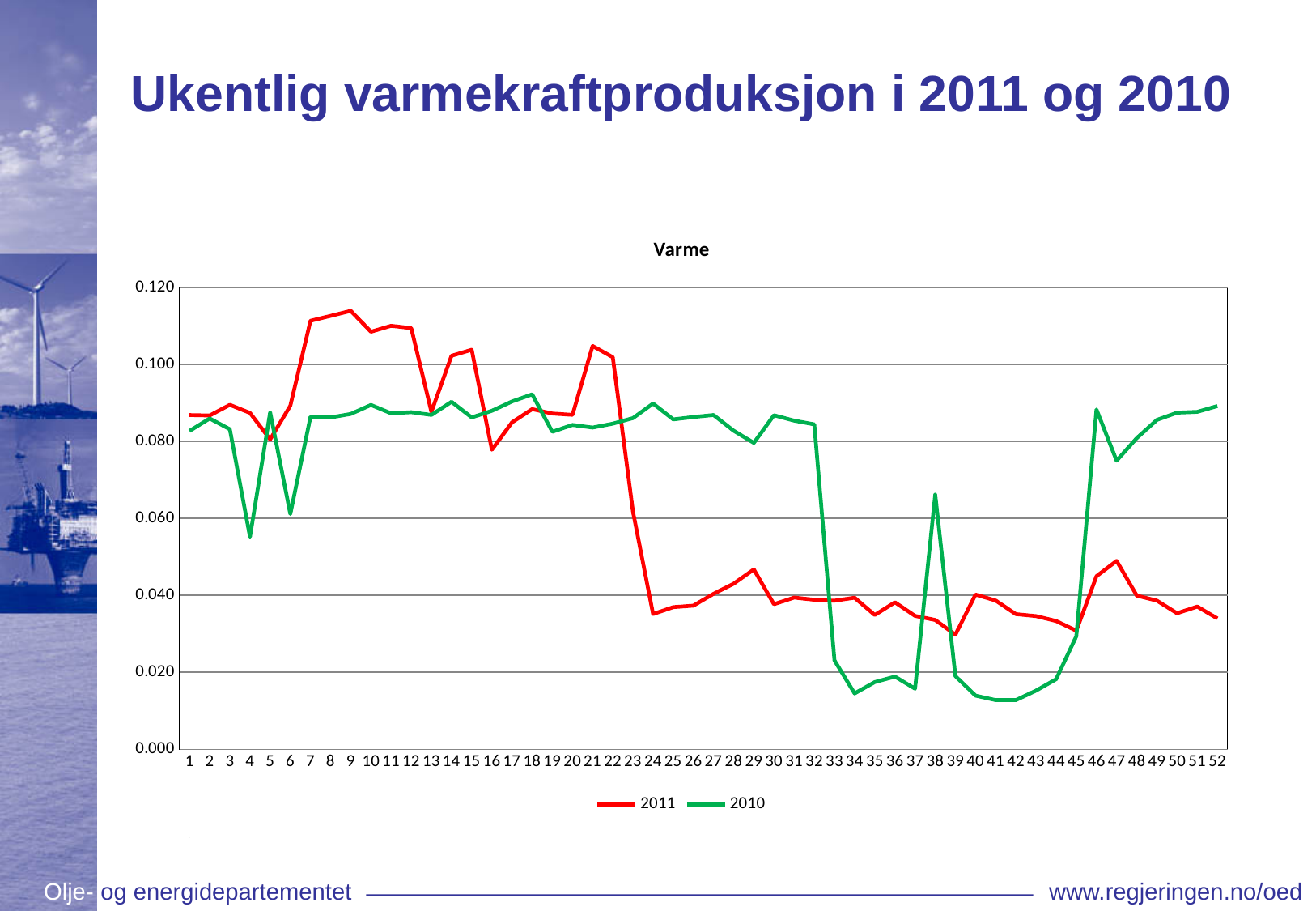
In week 50, which series has the higher value, 2011 or 2010? 2010 Is the value for 2011 in week 9 greater or less than 0.100? greater Is the value for 2011 in week 47 greater or less than 0.040? greater How many series does the legend list? 2 Is the value for 2010 in week 34 greater or less than 0.020? less How many weeks are plotted along the x axis? 52 In week 9, which series has the higher value, 2011 or 2010? 2011 Which colour is used for the 2011 series? red What kind of chart is shown on the slide? line chart Does the 2011 series rise or fall between week 22 and week 24? fall What is the title printed above the chart? Varme